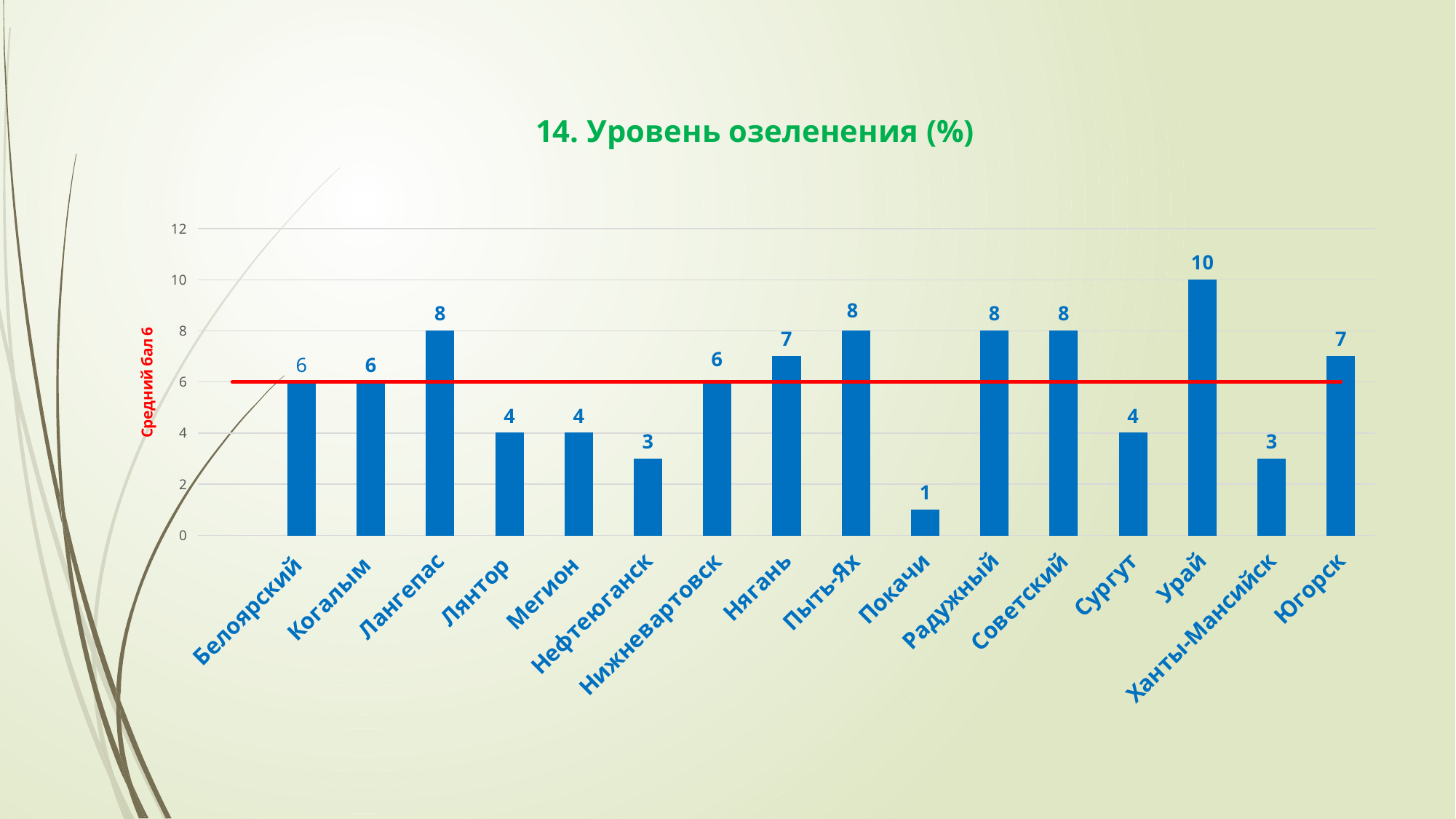
Which city has the lowest value? Покачи Which city has the highest value? Урай What is the value for Ханты-Мансийск? 3 Which is larger, the value for Сургут or the value for Югорск? Югорск What is the difference between the values for Урай and Покачи? 9 How many cities are shown on the x axis? 16 What is the value for Урай? 10 What is the title of the chart? 14. Уровень озеленения (%) What is the value for Покачи? 1 What kind of chart is this? bar chart What is the difference between the values for Лангепас and Лянтор? 4 What is the value for Нягань? 7